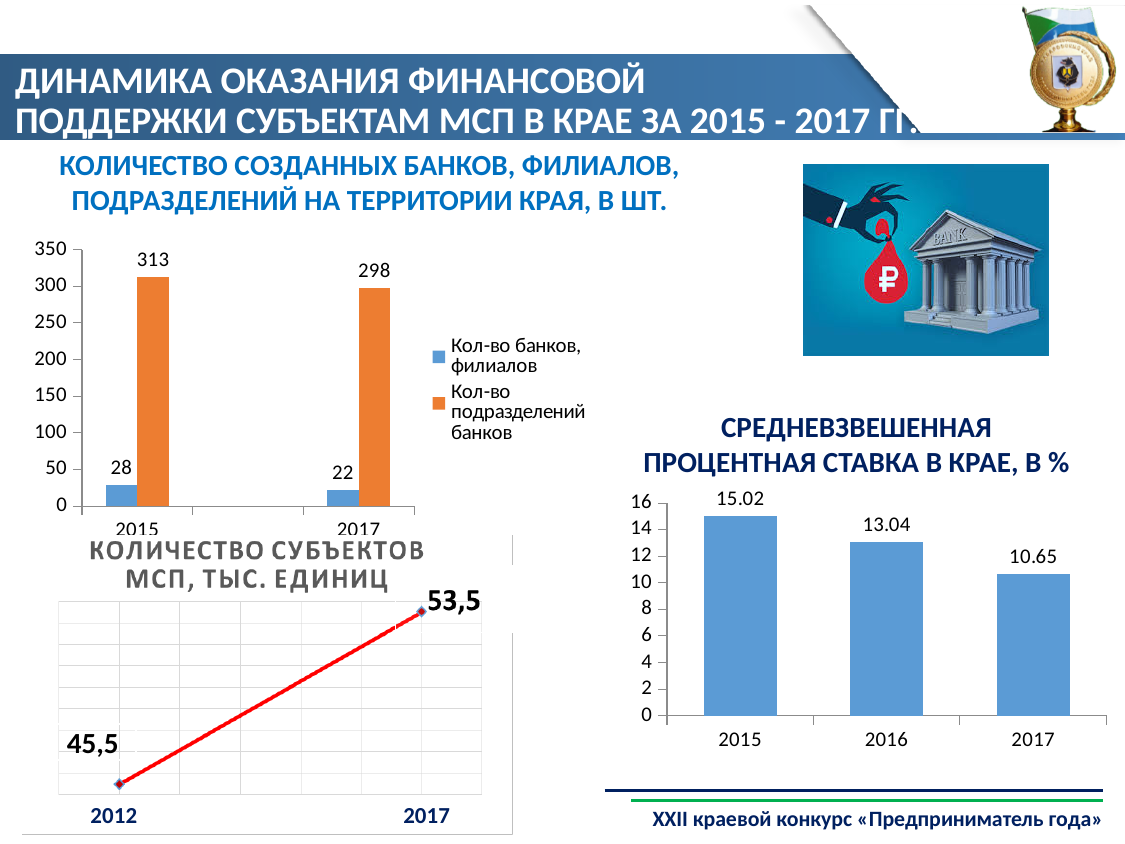
In the right chart (СРЕДНЕВЗВЕШЕННАЯ ПРОЦЕНТНАЯ СТАВКА В КРАЕ, В %), what is the value for 2016? 13.04 In the bottom-left chart (КОЛИЧЕСТВО СУБЪЕКТОВ МСП, ТЫС. ЕДИНИЦ), what kind of chart is shown? Line chart In the right chart (СРЕДНЕВЗВЕШЕННАЯ ПРОЦЕНТНАЯ СТАВКА В КРАЕ, В %), how many years are shown on the x axis? 3 In the bottom-left chart (КОЛИЧЕСТВО СУБЪЕКТОВ МСП, ТЫС. ЕДИНИЦ), do the values rise or fall from 2012 to 2017? Rise In the top-left chart (КОЛИЧЕСТВО СОЗДАННЫХ БАНКОВ, ФИЛИАЛОВ, ПОДРАЗДЕЛЕНИЙ), which colour represents Кол-во подразделений банков? Orange In the top-left chart (КОЛИЧЕСТВО СОЗДАННЫХ БАНКОВ, ФИЛИАЛОВ, ПОДРАЗДЕЛЕНИЙ), which year has the higher value for Кол-во банков, филиалов, 2015 or 2017? 2015 In the top-left chart (КОЛИЧЕСТВО СОЗДАННЫХ БАНКОВ, ФИЛИАЛОВ, ПОДРАЗДЕЛЕНИЙ), how many series does the legend list? 2 In the top-left chart (КОЛИЧЕСТВО СОЗДАННЫХ БАНКОВ, ФИЛИАЛОВ, ПОДРАЗДЕЛЕНИЙ), by how much did Кол-во подразделений банков decrease from 2015 to 2017? 15 In the right chart (СРЕДНЕВЗВЕШЕННАЯ ПРОЦЕНТНАЯ СТАВКА В КРАЕ, В %), which year has the lowest value? 2017 In the bottom-left chart (КОЛИЧЕСТВО СУБЪЕКТОВ МСП, ТЫС. ЕДИНИЦ), what is the value for 2012? 45,5 In the top-left chart (КОЛИЧЕСТВО СОЗДАННЫХ БАНКОВ, ФИЛИАЛОВ, ПОДРАЗДЕЛЕНИЙ), what is the value for Кол-во банков, филиалов in 2017? 22 In the top-left chart (КОЛИЧЕСТВО СОЗДАННЫХ БАНКОВ, ФИЛИАЛОВ, ПОДРАЗДЕЛЕНИЙ), what is the value for Кол-во подразделений банков in 2015? 313